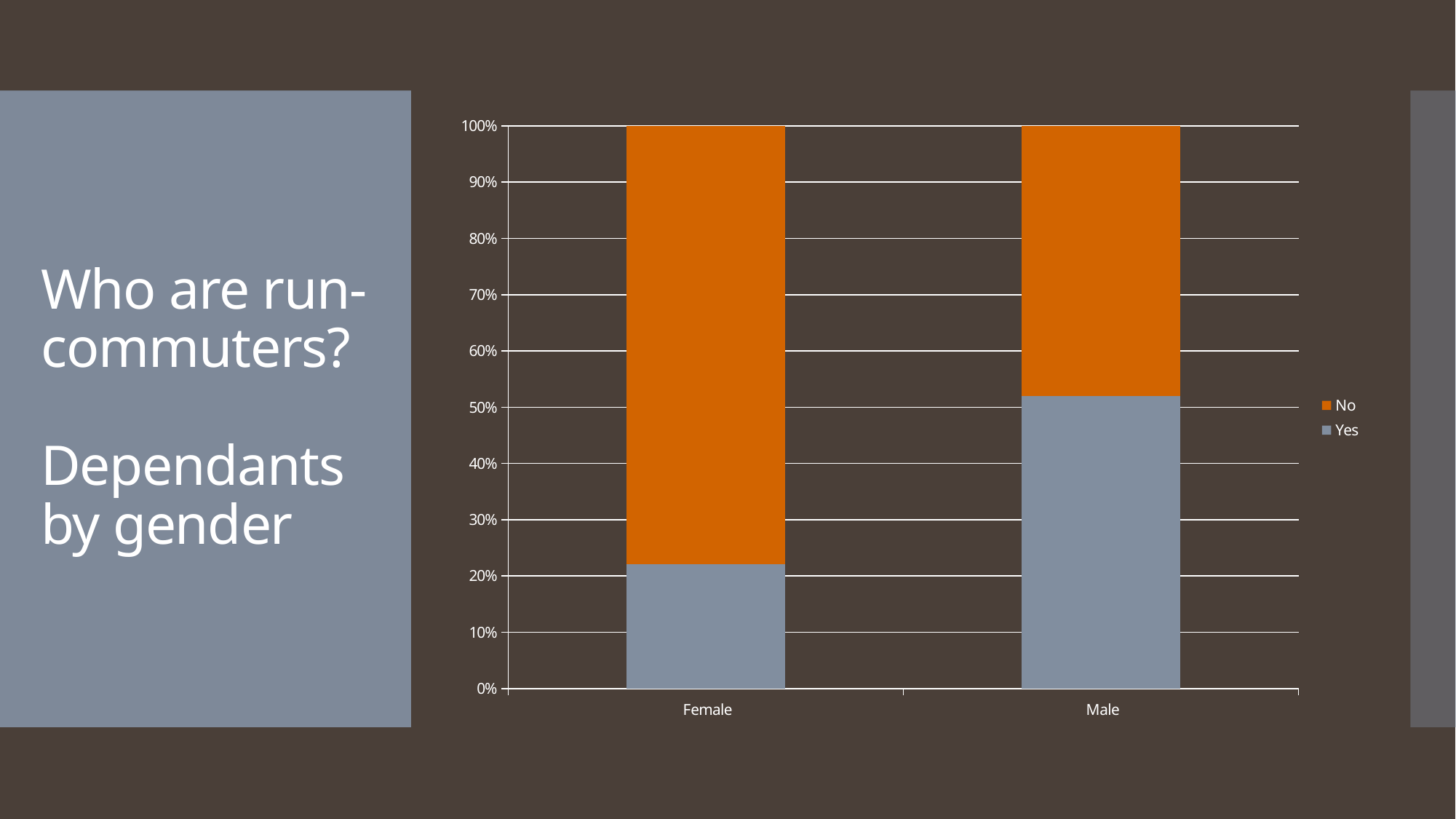
Which category has the larger "Yes" share, Female or Male? Male What kind of chart is shown on the slide? Stacked bar chart What colour represents the "No" series in the chart? Orange Is the "No" value for Female greater or less than 70%? greater Is the "Yes" value for Male greater or less than 40%? greater Is the "Yes" value for Female greater or less than 30%? less What is the total height of the stacked bar for Female? 100% Which two series are listed in the chart's legend? No and Yes How many series does the chart's legend list? 2 How many categories are shown on the x axis of the chart? 2 Which category has the larger "No" share, Female or Male? Female